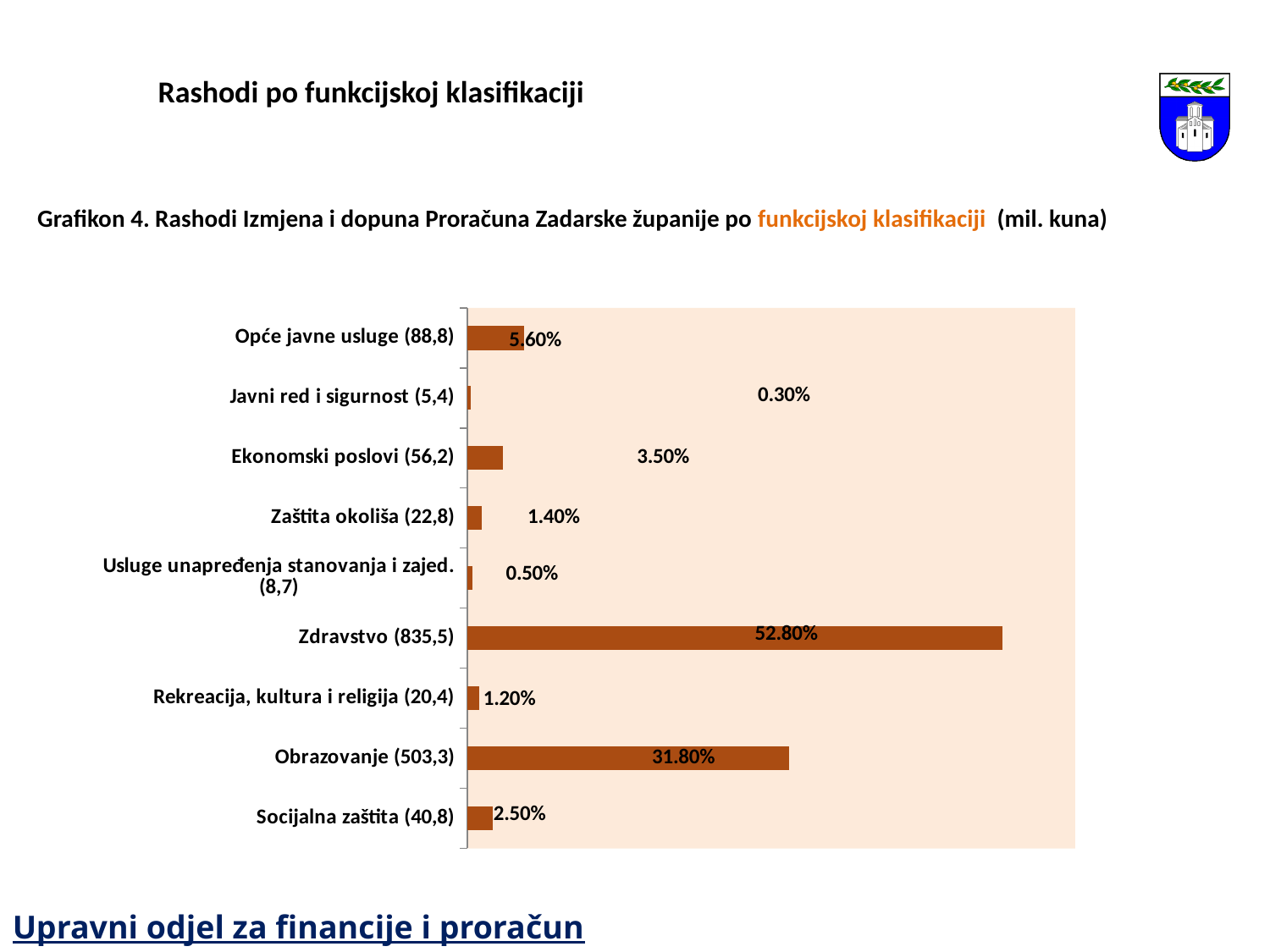
What is the value shown for Zdravstvo (835,5)? 52.80% Which category has the lowest value? Javni red i sigurnost (5,4) What is the value shown for Socijalna zaštita (40,8)? 2.50% Which is larger, the value for Ekonomski poslovi (56,2) or the value for Socijalna zaštita (40,8)? Ekonomski poslovi (56,2) What is the value shown for Zaštita okoliša (22,8)? 1.40% What is the difference between the values for Zdravstvo (835,5) and Obrazovanje (503,3)? 21.00% How many categories are plotted in the chart? 9 What is the value shown for Obrazovanje (503,3)? 31.80% What is the title of the chart as given on the slide? Grafikon 4. Rashodi Izmjena i dopuna Proračuna Zadarske županije po funkcijskoj klasifikaciji (mil. kuna) What type of chart is shown on the slide? bar chart Which category has the highest value? Zdravstvo (835,5) What is the value shown for Opće javne usluge (88,8)? 5.60%